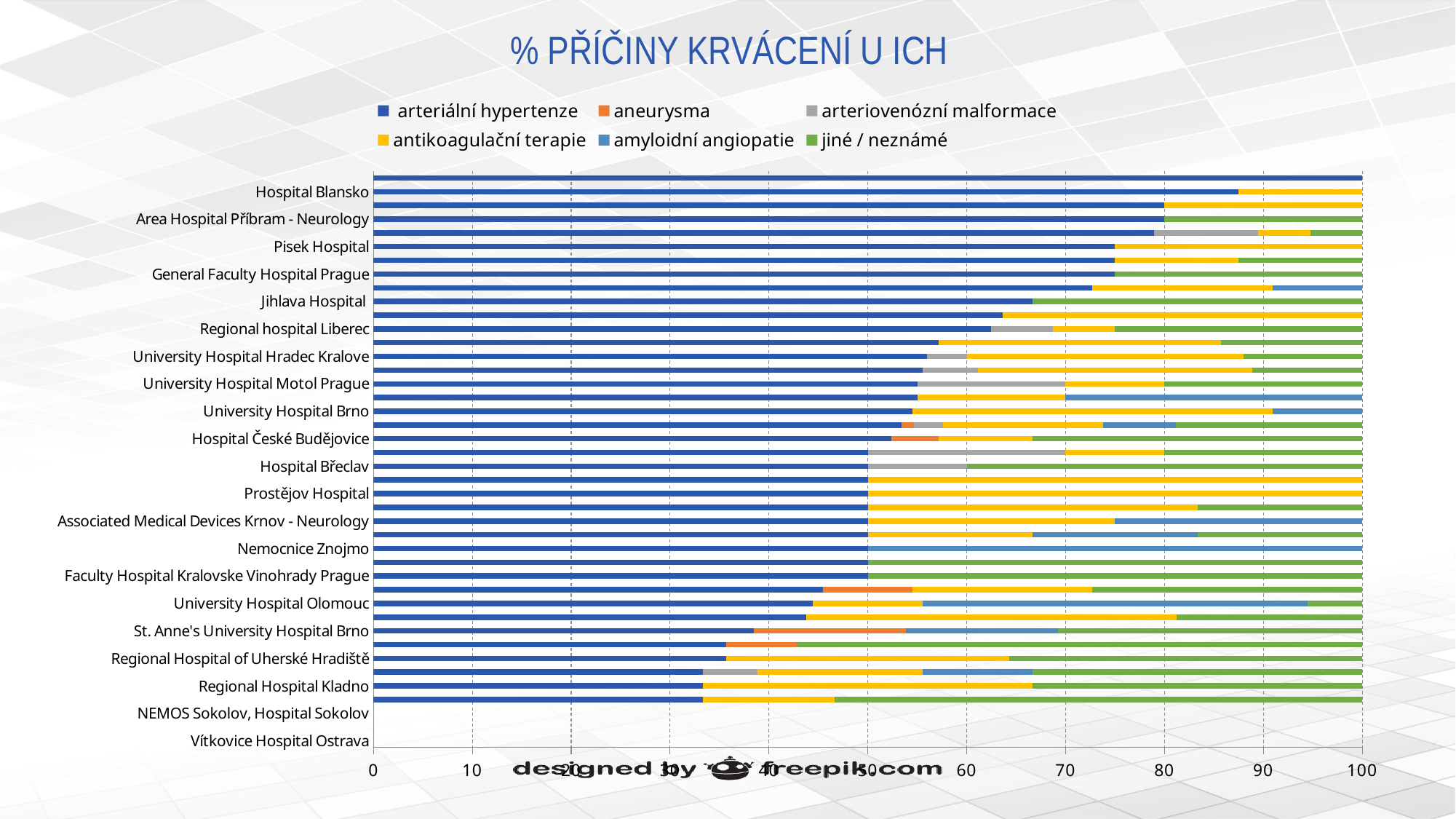
Going from the top of the chart to the bottom, do the arteriální hypertenze values rise or fall? fall How many series does the legend list? 6 Is the arteriální hypertenze value for Hospital Blansko greater or less than 80? greater Is the arteriální hypertenze value for St. Anne's University Hospital Brno greater or less than 50? less Which colour represents the series 'aneurysma' in the legend? orange What kind of chart is shown on the slide? stacked bar chart Is the arteriální hypertenze value for Regional Hospital Kladno greater or less than 40? less What is the title of the chart? % PŘÍČINY KRVÁCENÍ U ICH Which has the larger arteriální hypertenze value, Hospital Blansko or Regional Hospital Kladno? Hospital Blansko